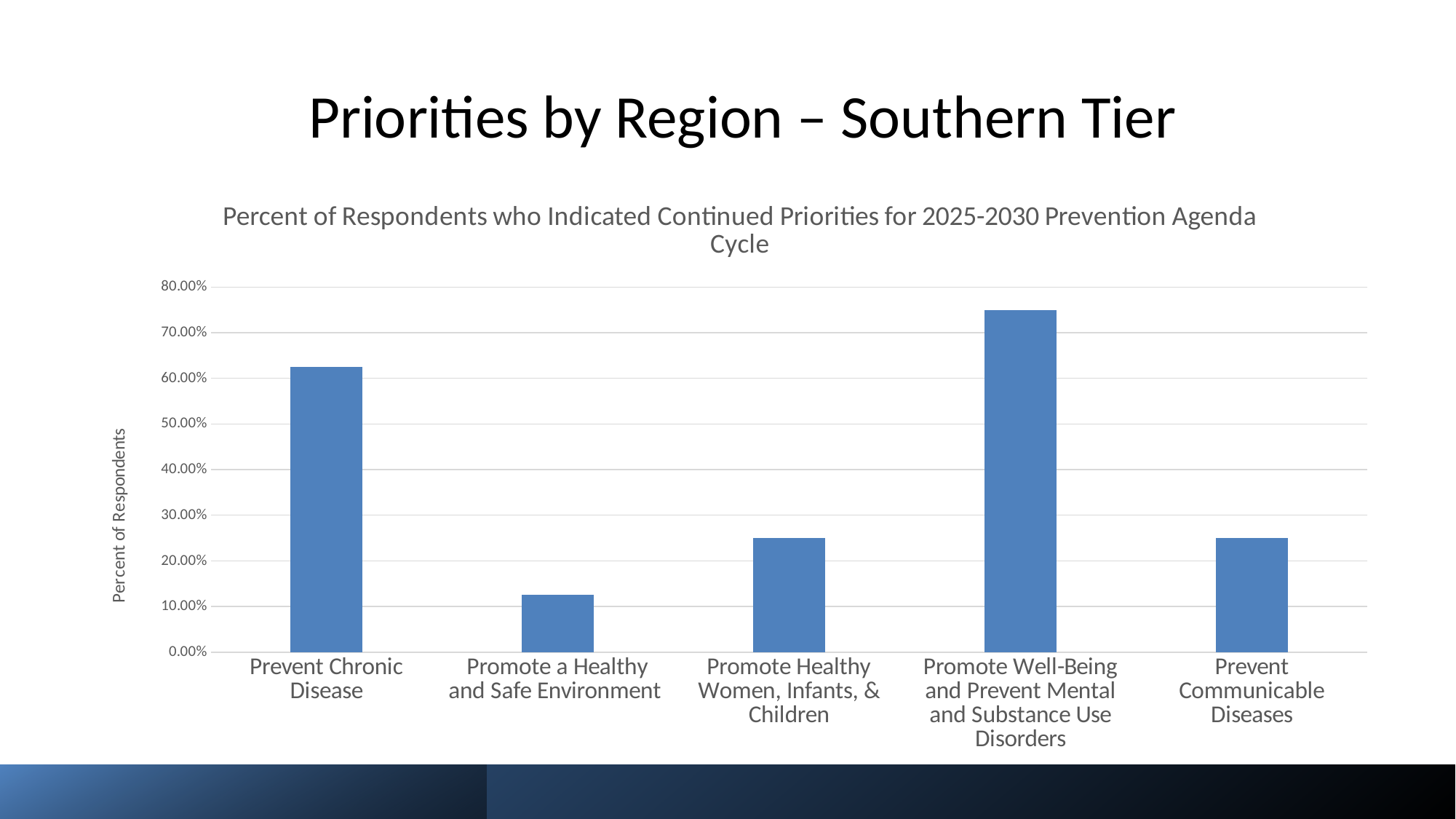
Which is larger, the value for Prevent Chronic Disease or the value for Prevent Communicable Diseases? Prevent Chronic Disease Is the value for Promote Well-Being and Prevent Mental and Substance Use Disorders greater or less than 70.00%? greater Which category has the highest value? Promote Well-Being and Prevent Mental and Substance Use Disorders Is the value for Prevent Communicable Diseases greater or less than 30.00%? less What kind of chart is shown on the slide? bar chart Is the value for Promote Healthy Women, Infants, & Children greater or less than 40.00%? less Which category has the lowest value? Promote a Healthy and Safe Environment How many categories are shown on the x axis? 5 What is the label on the vertical axis of the chart? Percent of Respondents Which is larger, the value for Promote Well-Being and Prevent Mental and Substance Use Disorders or the value for Promote Healthy Women, Infants, & Children? Promote Well-Being and Prevent Mental and Substance Use Disorders